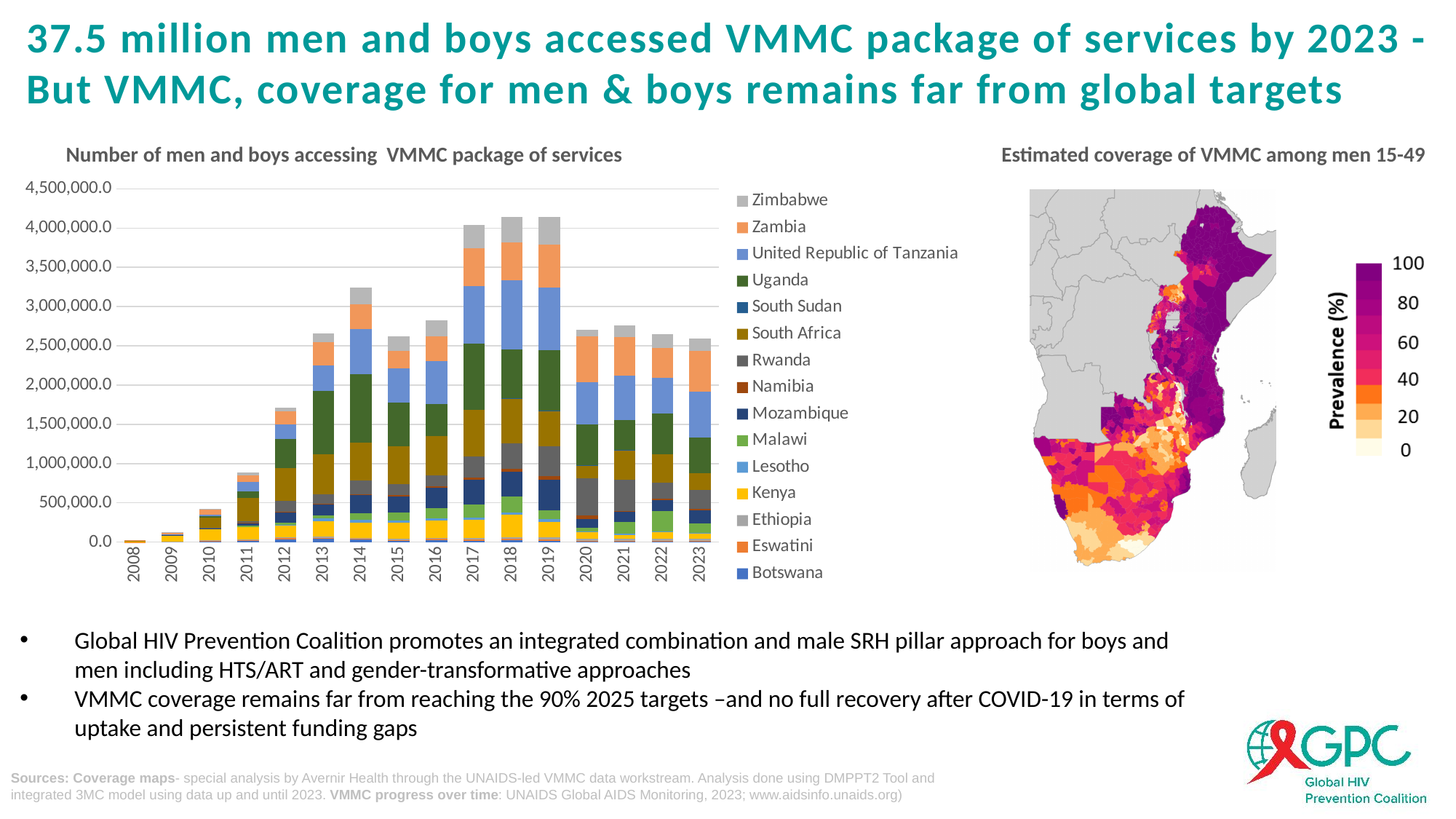
What is the title of the bar chart on the left of the slide? Number of men and boys accessing VMMC package of services How many countries does the legend of the bar chart list? 15 Is the total for 2020 in the bar chart greater or less than 3,000,000? less Do the totals in the bar chart rise or fall from 2008 to 2014? Rise In the bar chart, which year has a larger total: 2019 or 2020? 2019 Is the total for 2018 in the bar chart greater or less than 4,000,000? greater In the bar chart, which year has a larger total: 2012 or 2013? 2013 Is the total for 2008 in the bar chart greater or less than 500,000? less How many years are shown on the x axis of the bar chart? 16 Which year has the lowest total number of men and boys accessing VMMC services in the bar chart? 2008 What kind of chart is used to show the number of men and boys accessing VMMC package of services? Stacked bar chart